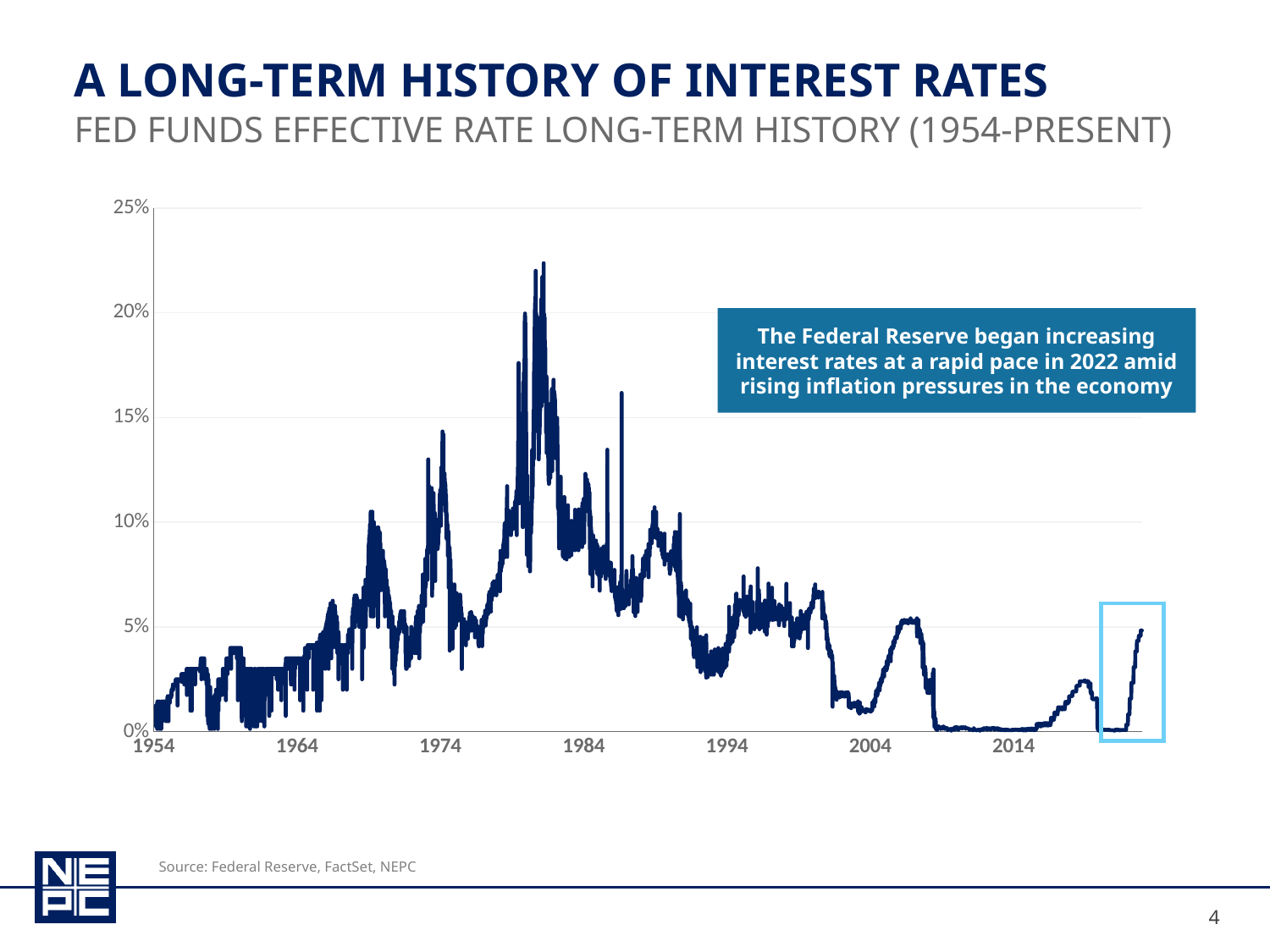
Is the fed funds effective rate around 1974 greater or less than 5%? greater In which decade does the fed funds effective rate reach its highest peak? The early 1980s Is the fed funds effective rate around 2014 greater or less than 5%? less What is the subtitle describing the data series plotted on the chart? Fed Funds Effective Rate Long-Term History (1954-Present) What is the title of the chart on the slide? A Long-Term History of Interest Rates How many year labels are shown on the x axis? 7 Is the highest peak of the fed funds effective rate greater or less than 20%? greater What is the highest value labeled on the y axis? 25% What kind of chart is shown on the slide? Line chart From the peak in the early 1980s to around 2014, does the fed funds effective rate generally rise or fall? Fall